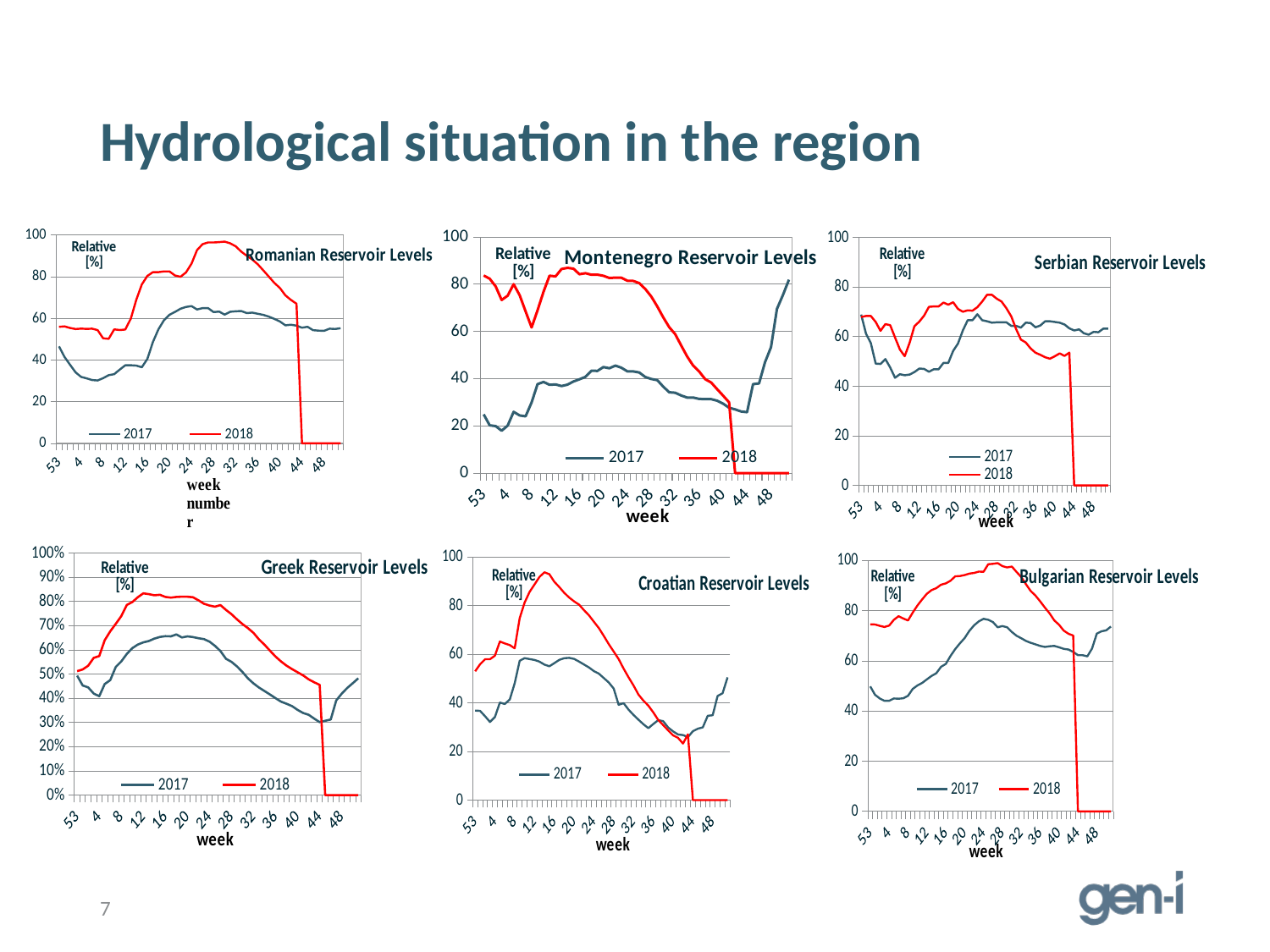
On the Croatian Reservoir Levels chart, is the 2018 value at week 12 greater or less than 80? greater On the Romanian Reservoir Levels chart, is the 2018 value at week 28 greater or less than 80? greater On the Montenegro Reservoir Levels chart, is the 2017 value at week 4 greater or less than 40? less How many series does the legend of the Montenegro Reservoir Levels chart list? 2 On the Romanian Reservoir Levels chart, which series has the larger value at week 28, 2017 or 2018? 2018 On the Montenegro Reservoir Levels chart, which series has the larger value at week 48, 2017 or 2018? 2017 What kind of chart is the Romanian Reservoir Levels chart? line chart How many charts are shown on the slide? 6 What are the legend entries on the Serbian Reservoir Levels chart? 2017 and 2018